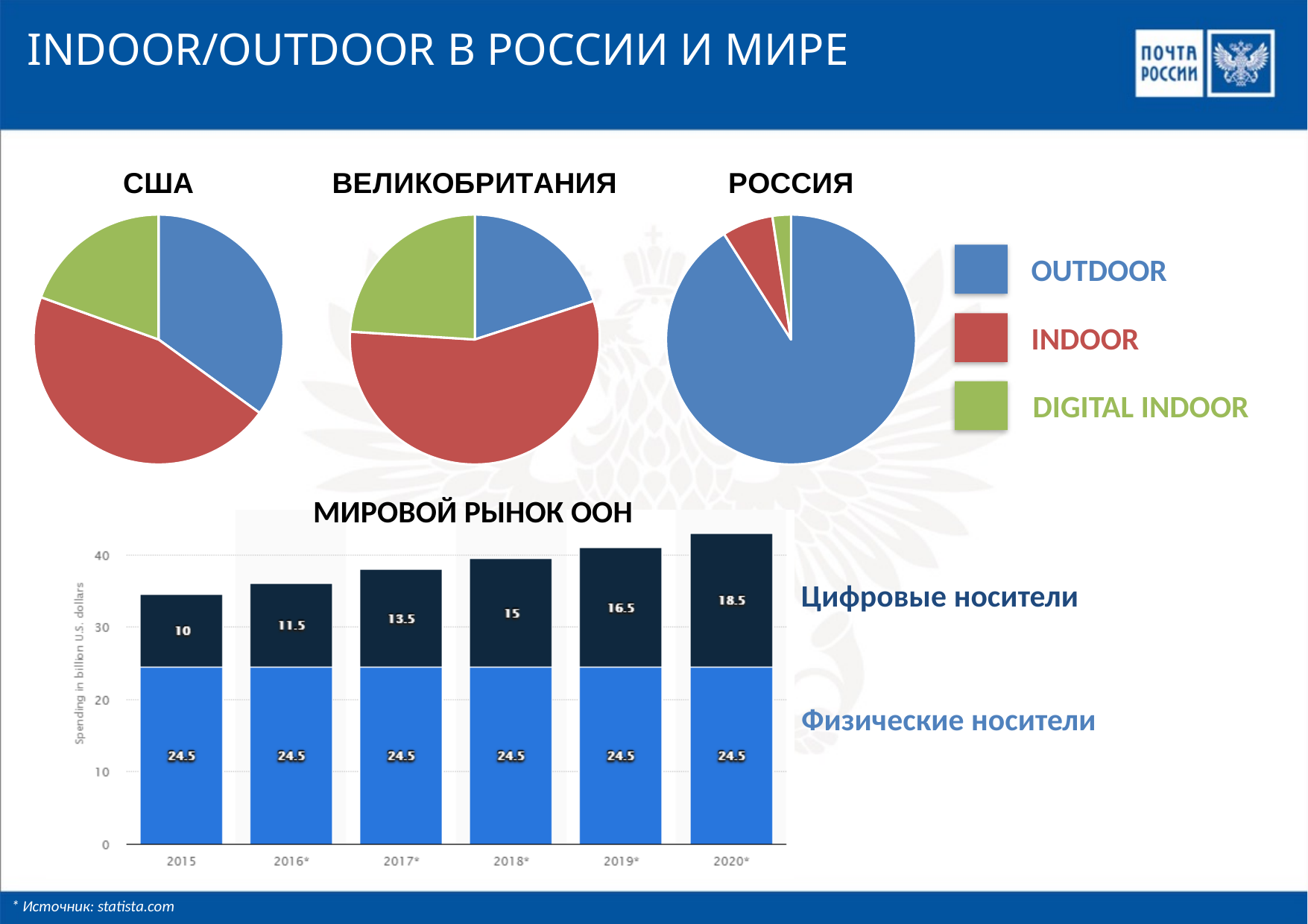
In the МИРОВОЙ РЫНОК ООН chart, what is the value for Цифровые носители in 2020*? 18.5 In the МИРОВОЙ РЫНОК ООН chart, what is the difference between the Цифровые носители values for 2020* and 2015? 8.5 In the РОССИЯ pie chart, which category has the largest share? OUTDOOR In the МИРОВОЙ РЫНОК ООН chart, what is the value for Цифровые носители in 2015? 10 In the МИРОВОЙ РЫНОК ООН chart, which year has the highest value for Цифровые носители? 2020* In the МИРОВОЙ РЫНОК ООН chart, what is the value for Физические носители in 2018*? 24.5 In the МИРОВОЙ РЫНОК ООН chart, do the Цифровые носители values rise or fall from 2015 to 2020*? rise In the МИРОВОЙ РЫНОК ООН chart, what is the total of the stacked bar for 2017*? 38 In the ВЕЛИКОБРИТАНИЯ pie chart, which category has the largest share? INDOOR What kind of chart is МИРОВОЙ РЫНОК ООН? stacked bar chart How many categories does the legend for the pie charts list? 3 In the МИРОВОЙ РЫНОК ООН chart, how many years are shown on the x axis? 6